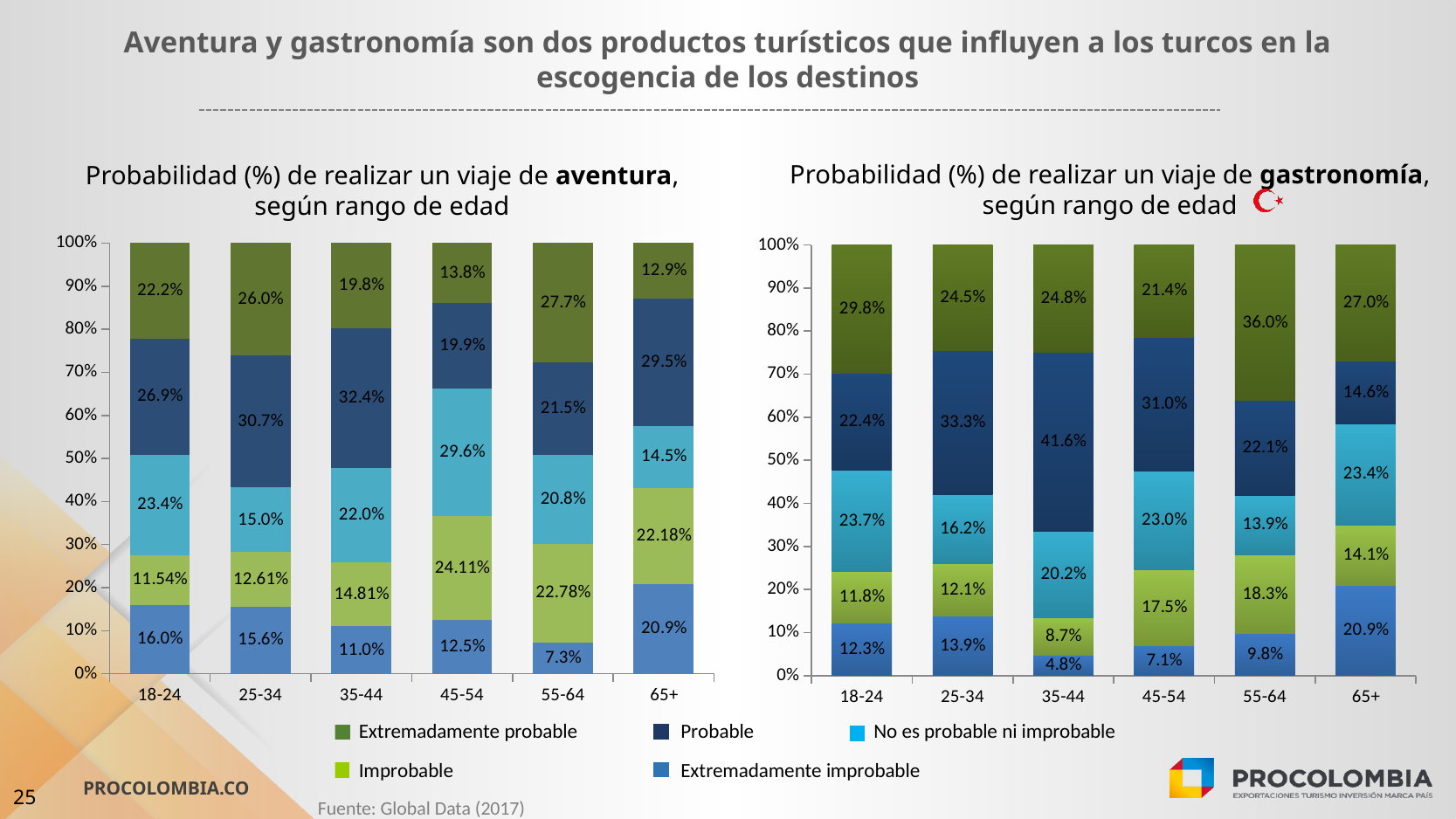
In the gastronomía chart (right), what is the value for Extremadamente probable in the 55-64 age group? 36.0% What kind of chart is the gastronomía chart (right)? Stacked bar chart In the aventura chart (left), what is the value for Probable in the 35-44 age group? 32.4% In the aventura chart (left), which age group has the lowest value for Extremadamente improbable? 55-64 In the gastronomía chart (right), which age group has the larger Extremadamente improbable value, 18-24 or 25-34? 25-34 How many age groups are shown on the x axis of the aventura chart (left)? 6 What source is cited for the data on the slide? Global Data (2017) How many series does the legend list for the charts? 5 In the gastronomía chart (right), which age group has the highest value for Probable? 35-44 In the aventura chart (left), which age group has the highest value for Extremadamente probable? 55-64 In the gastronomía chart (right), what is the value for Improbable in the 35-44 age group? 8.7% In the aventura chart (left), what is the difference between the Extremadamente probable values for 55-64 and 65+? 14.8 percentage points